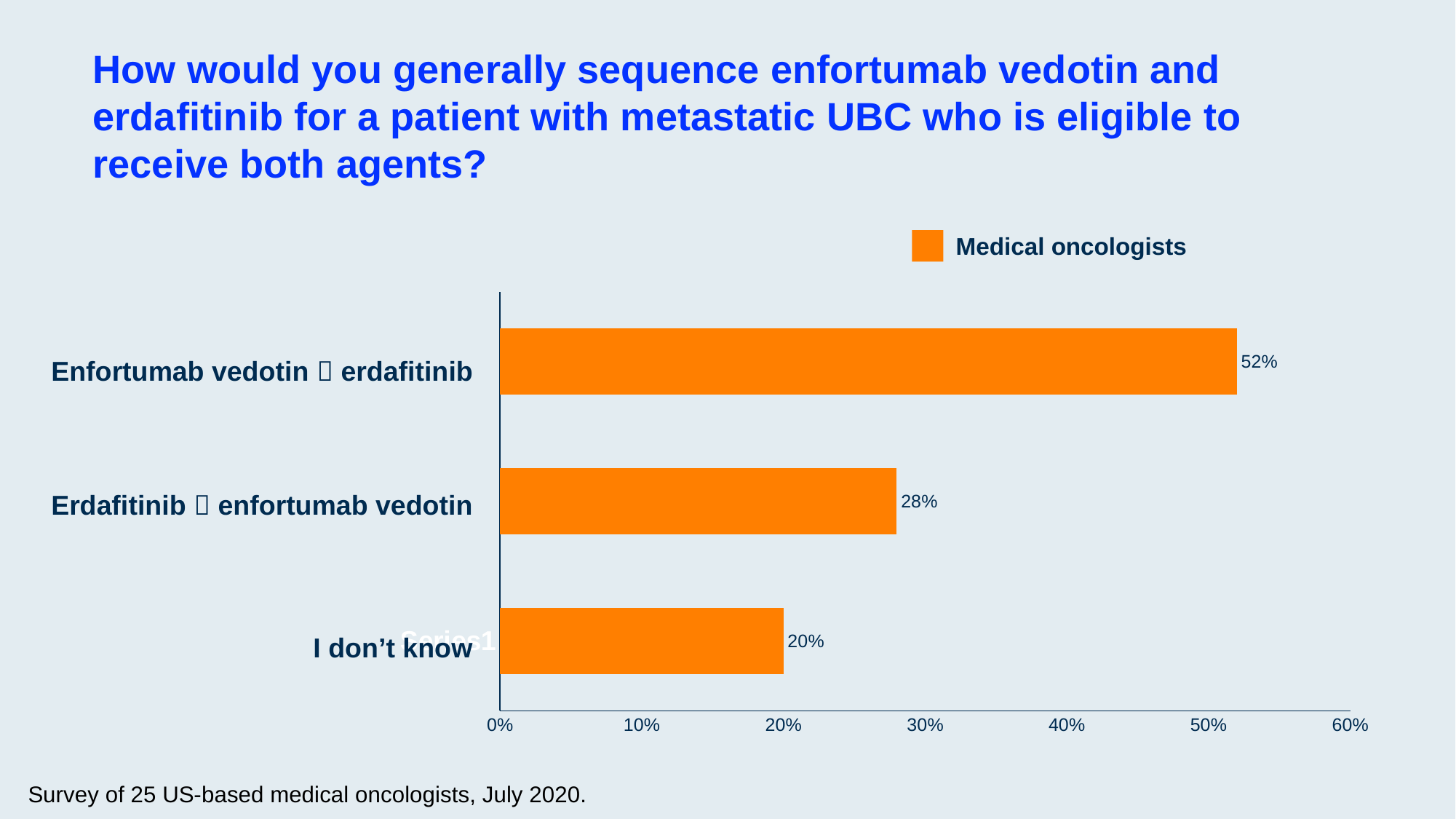
Which response option has the highest percentage? Enfortumab vedotin followed by erdafitinib Is the value for the enfortumab vedotin-first sequence greater or less than 50%? greater Which is larger: the percentage for erdafitinib followed by enfortumab vedotin, or the percentage for "I don't know"? Erdafitinib followed by enfortumab vedotin What percentage of medical oncologists answered "I don't know"? 20% What percentage of medical oncologists chose the sequence enfortumab vedotin followed by erdafitinib? 52% What series name appears in the chart legend? Medical oncologists Which response option has the lowest percentage? I don't know What kind of chart is shown on the slide? Bar chart What is the difference in percentage points between the enfortumab vedotin-first sequence and the erdafitinib-first sequence? 24 percentage points What percentage of medical oncologists chose the sequence erdafitinib followed by enfortumab vedotin? 28% How many response options are shown in the chart? 3 How many series does the legend list? 1